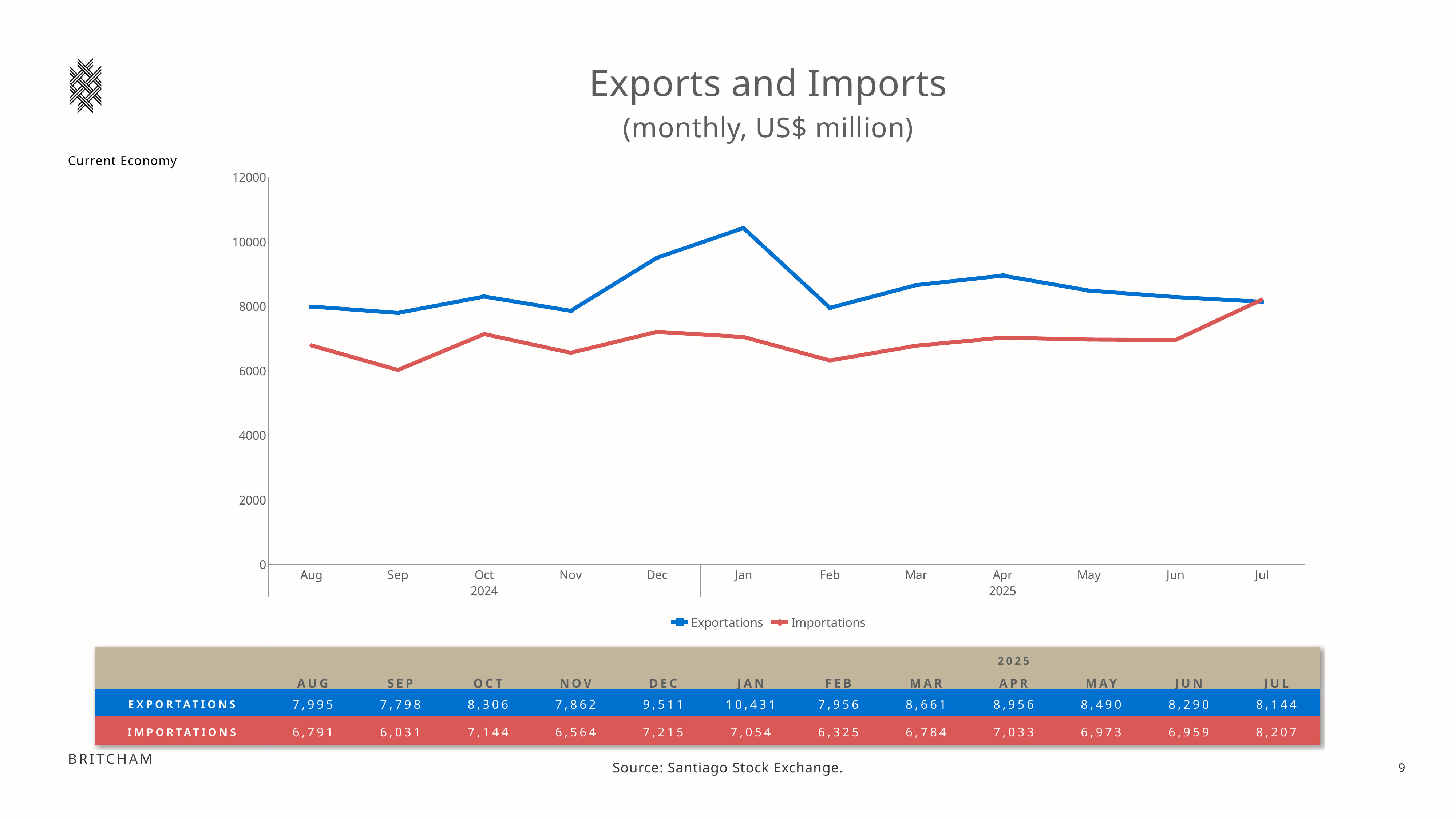
How many series does the legend list? 2 What is the value of Importations in Sep 2024? 6,031 What colour is the Importations line? red In which month are Importations lowest? Sep Is the value of Exportations in Dec 2024 greater or less than 8000? greater What is the value of Exportations in Jan 2025? 10,431 Do Exportations rise or fall from Apr 2025 to Jul 2025? fall How many months are plotted along the x axis? 12 What type of chart is shown on the slide? line chart In which month are Exportations highest? Jan Which is larger in Jul 2025, Exportations or Importations? Importations What is the difference between Exportations and Importations in Jan 2025? 3,377